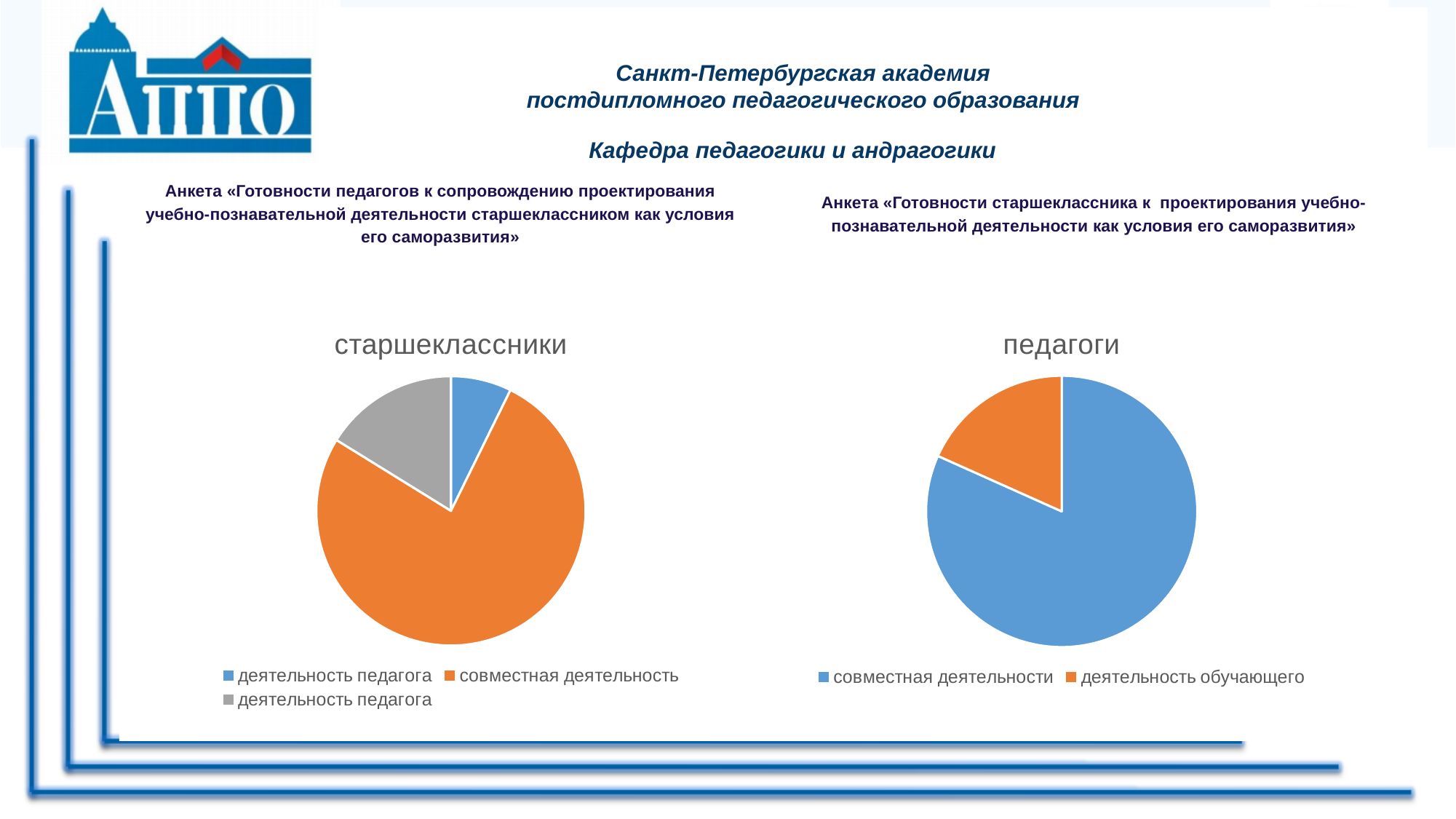
What is the title of the pie chart on the left side of the slide? старшеклассники In the chart titled «педагоги», what colour is the slice for деятельность обучающего? orange In the chart titled «педагоги», how many entries does the legend list? 2 In the chart titled «педагоги», which category has the largest slice? совместная деятельности In the chart titled «старшеклассники», which category has the largest slice? совместная деятельность In the chart titled «педагоги», which is larger: совместная деятельности or деятельность обучающего? совместная деятельности What kind of chart is the chart titled «педагоги»? pie chart In the chart titled «педагоги», which category has the smallest slice? деятельность обучающего In the chart titled «педагоги», how many slices does the pie have? 2 In the chart titled «старшеклассники», how many slices does the pie have? 3 In the chart titled «старшеклассники», how many entries does the legend list? 3 What kind of chart is the chart titled «старшеклассники»? pie chart